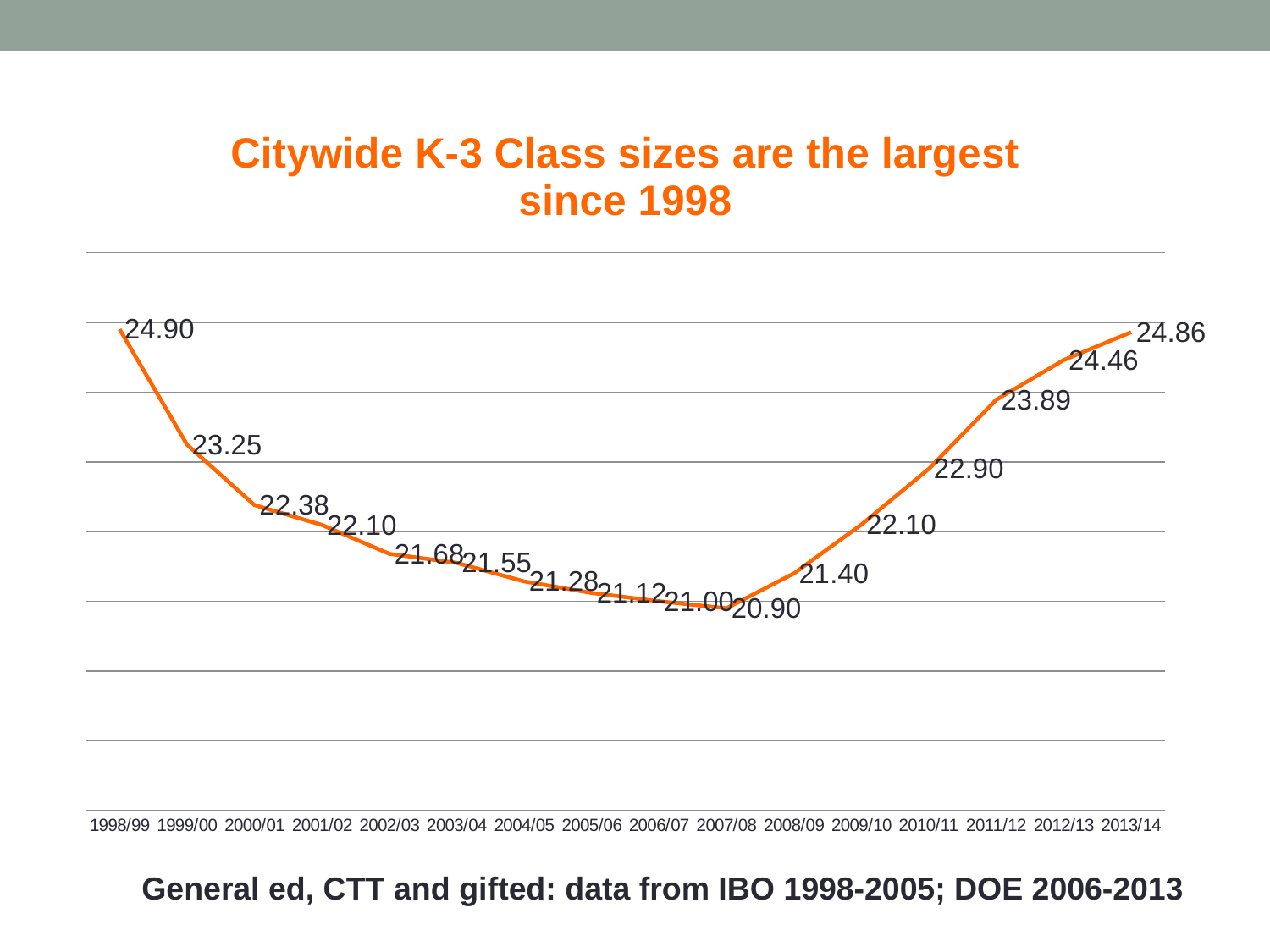
What type of chart is shown on the slide? Line chart What is the title of the chart? Citywide K-3 Class sizes are the largest since 1998 Do the values rise or fall from 2007/08 to 2013/14? Rise How many school years are plotted on the x axis? 16 What is the class size value for 2013/14? 24.86 What is the class size value for 1998/99? 24.90 What is the difference between the values for 1998/99 and 1999/00? 1.65 What is the class size value for 2011/12? 23.89 Which is larger, the value for 2009/10 or the value for 2012/13? 2012/13 What is the class size value for 2007/08? 20.90 Which school year has the highest class size value? 1998/99 Which school year has the lowest class size value? 2007/08